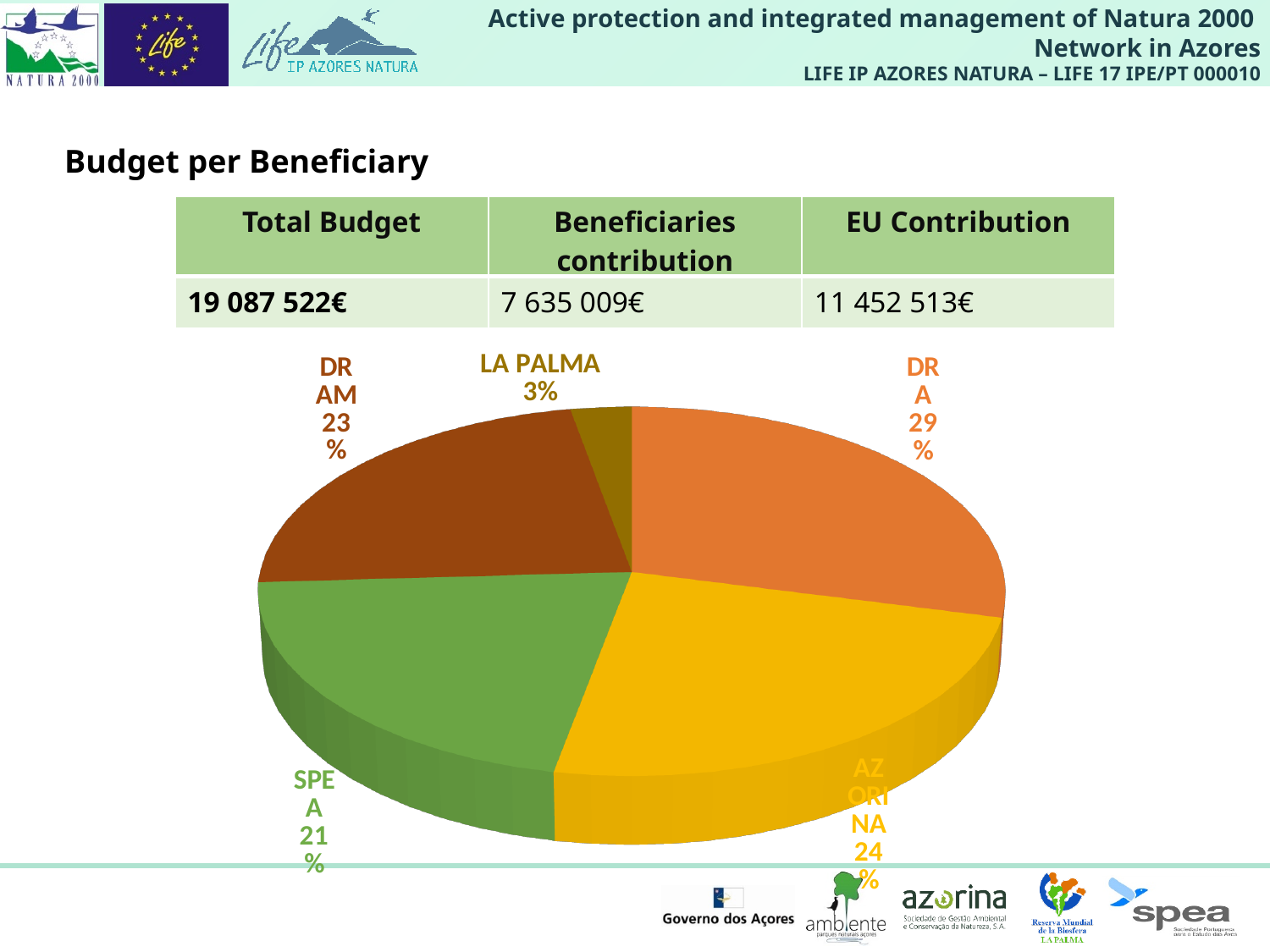
Which slice is larger, AZORINA or SPEA? AZORINA Which beneficiary has the smallest slice of the pie chart? LA PALMA What is the combined share of the DRAM and SPEA slices? 44% What share of the budget does LA PALMA receive in the pie chart? 3% What kind of chart is shown on the slide? pie chart What share of the budget does DRA receive in the pie chart? 29% Which beneficiary has the largest slice of the pie chart? DRA What share of the budget does AZORINA receive in the pie chart? 24% What is the difference in percentage points between the DRA slice and the DRAM slice? 6 What share of the budget does SPEA receive in the pie chart? 21% What colour is the DRA slice in the pie chart? orange How many slices does the pie chart have? 5